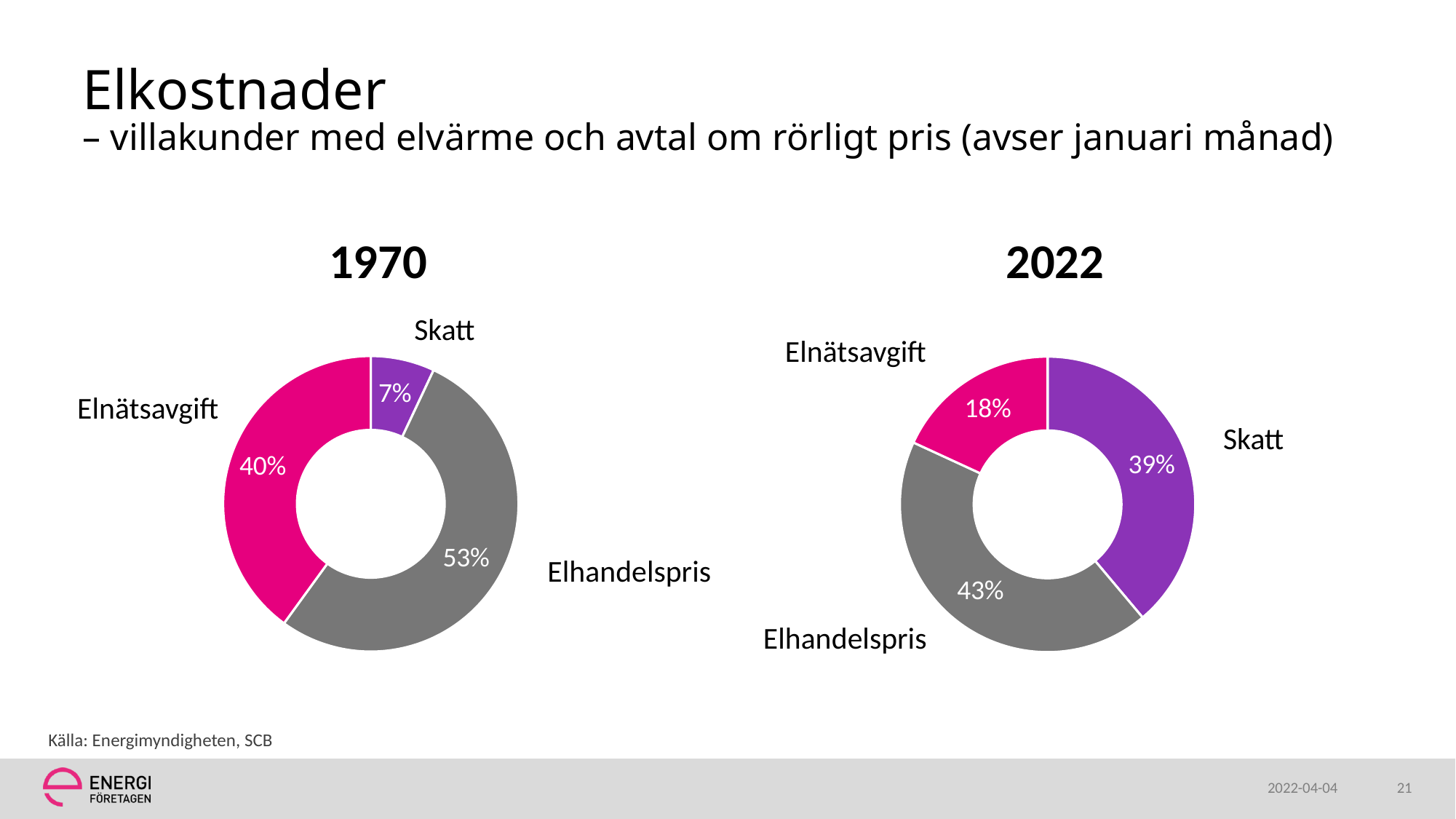
In the 1970 chart, what share is Skatt? 7% In the 1970 chart, what is the difference between the Elnätsavgift share and the Skatt share? 33 percentage points In the 1970 chart, which category has the smallest share? Skatt Which is larger in the 2022 chart: Skatt or Elnätsavgift? Skatt In the 2022 chart, what share is Skatt? 39% In the 2022 chart, which category has the smallest share? Elnätsavgift What type of chart is the 1970 chart? Doughnut (pie) chart How many categories does the 2022 chart show? 3 In the 2022 chart, what share is Elnätsavgift? 18% In the 1970 chart, which category has the largest share? Elhandelspris In the 2022 chart, what is the difference between the Elhandelspris share and the Skatt share? 4 percentage points In the 1970 chart, what share is Elhandelspris? 53%